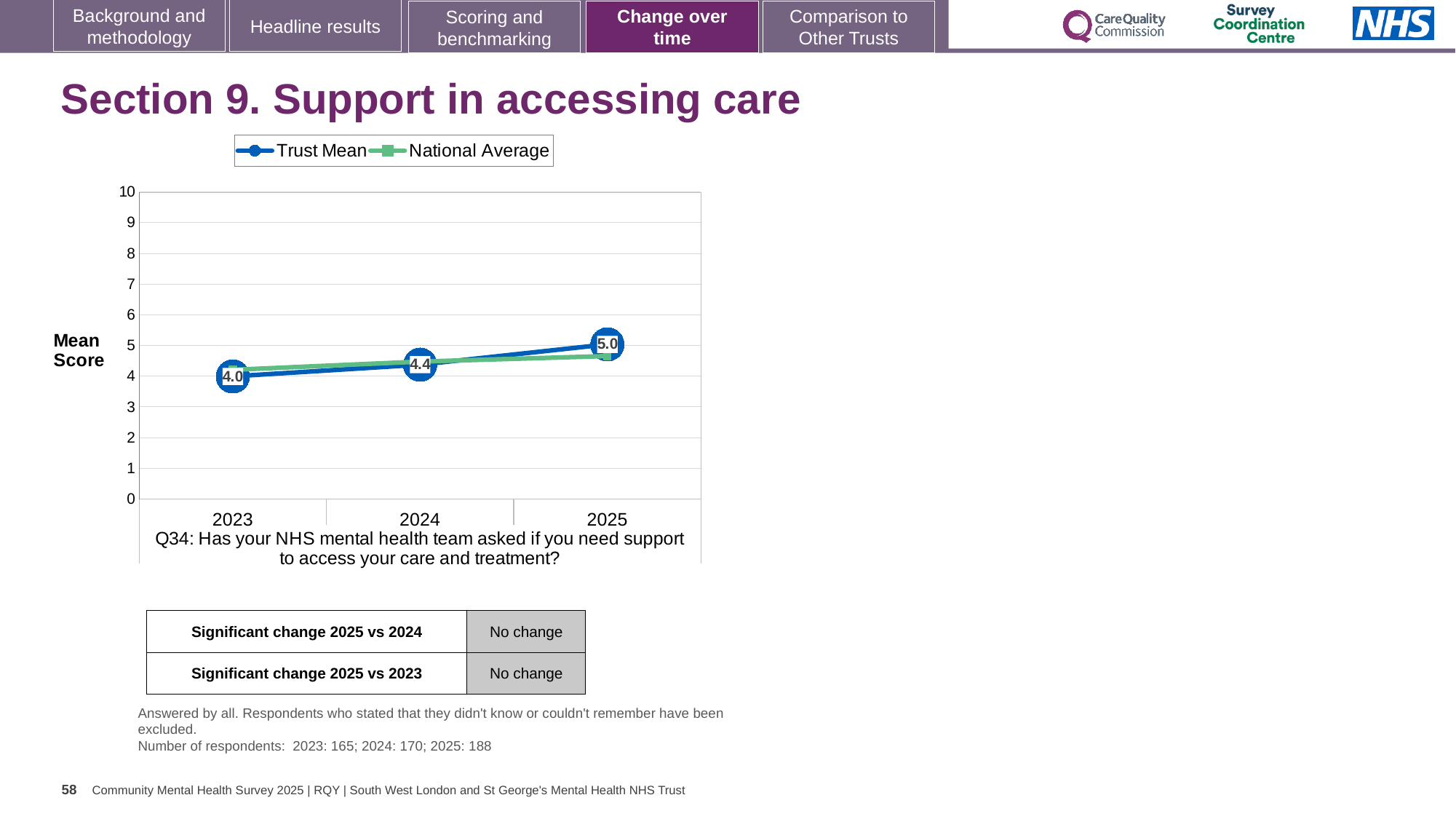
What is the Trust Mean score for 2024? 4.4 What is the Trust Mean score for 2023? 4.0 In 2025, which is larger, the Trust Mean or the National Average? Trust Mean What is the Trust Mean score for 2025? 5.0 How many series does the legend list? 2 Does the Trust Mean score rise or fall from 2023 to 2025? rise How many years are plotted on the chart? 3 In which year is the Trust Mean score lowest? 2023 What is the difference between the Trust Mean score in 2025 and in 2023? 1.0 Is the National Average value for 2025 greater or less than 5? less In which year is the Trust Mean score highest? 2025 What kind of chart is shown on the slide? line chart